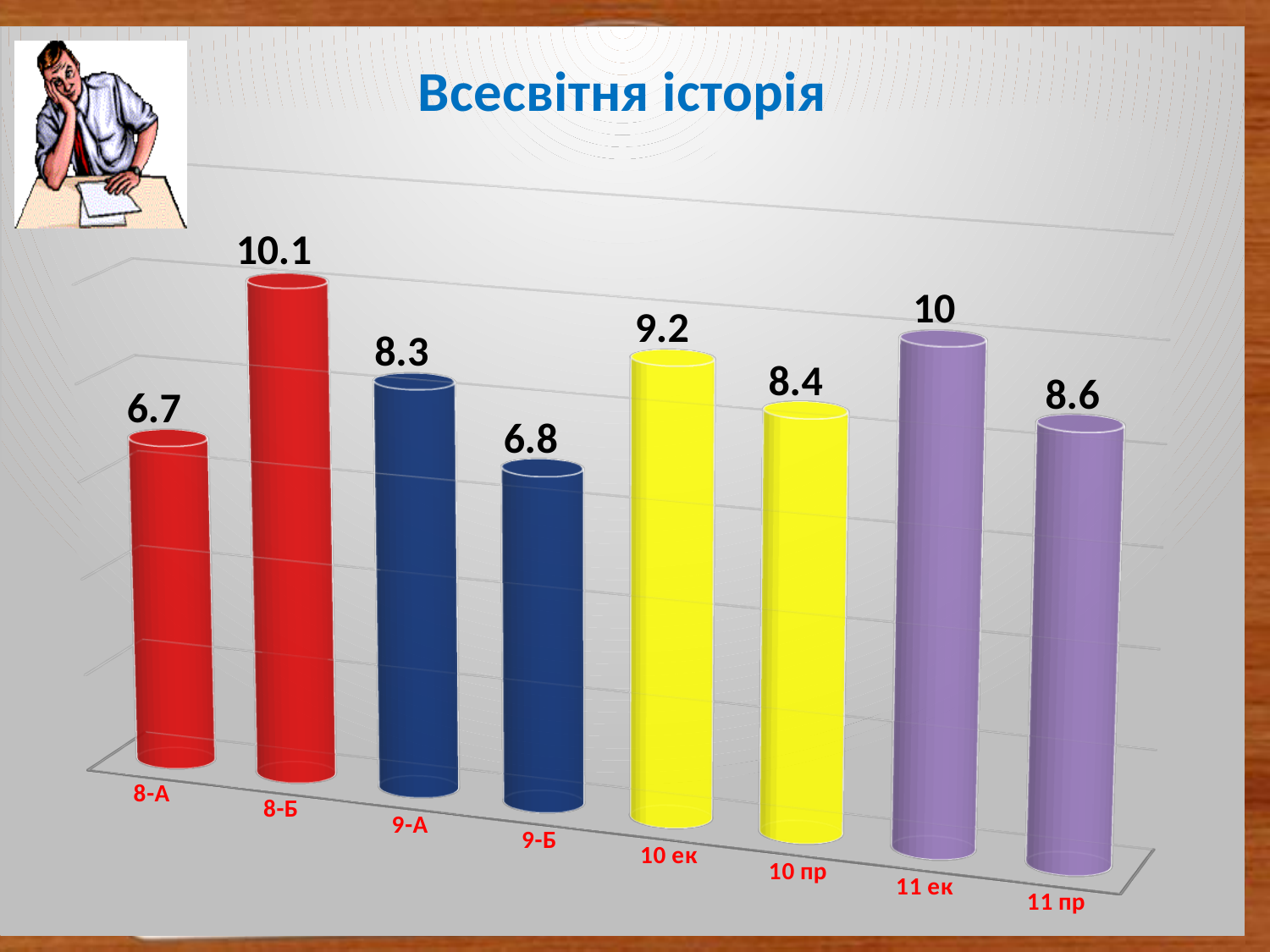
What is the difference between the values for 8-Б and 8-А? 3.4 What is the difference between the values for 11 ек and 10 пр? 1.6 What kind of chart is shown on the slide? bar chart Which category has the lowest value? 8-А What is the value for 11 пр? 8.6 Which is larger, the value for 10 ек or the value for 11 ек? 11 ек What is the value for 10 ек? 9.2 What is the title of the chart? Всесвітня історія What is the value for 8-Б? 10.1 Which is larger, the value for 9-А or the value for 10 пр? 10 пр How many categories are shown in the chart? 8 Which category has the highest value? 8-Б